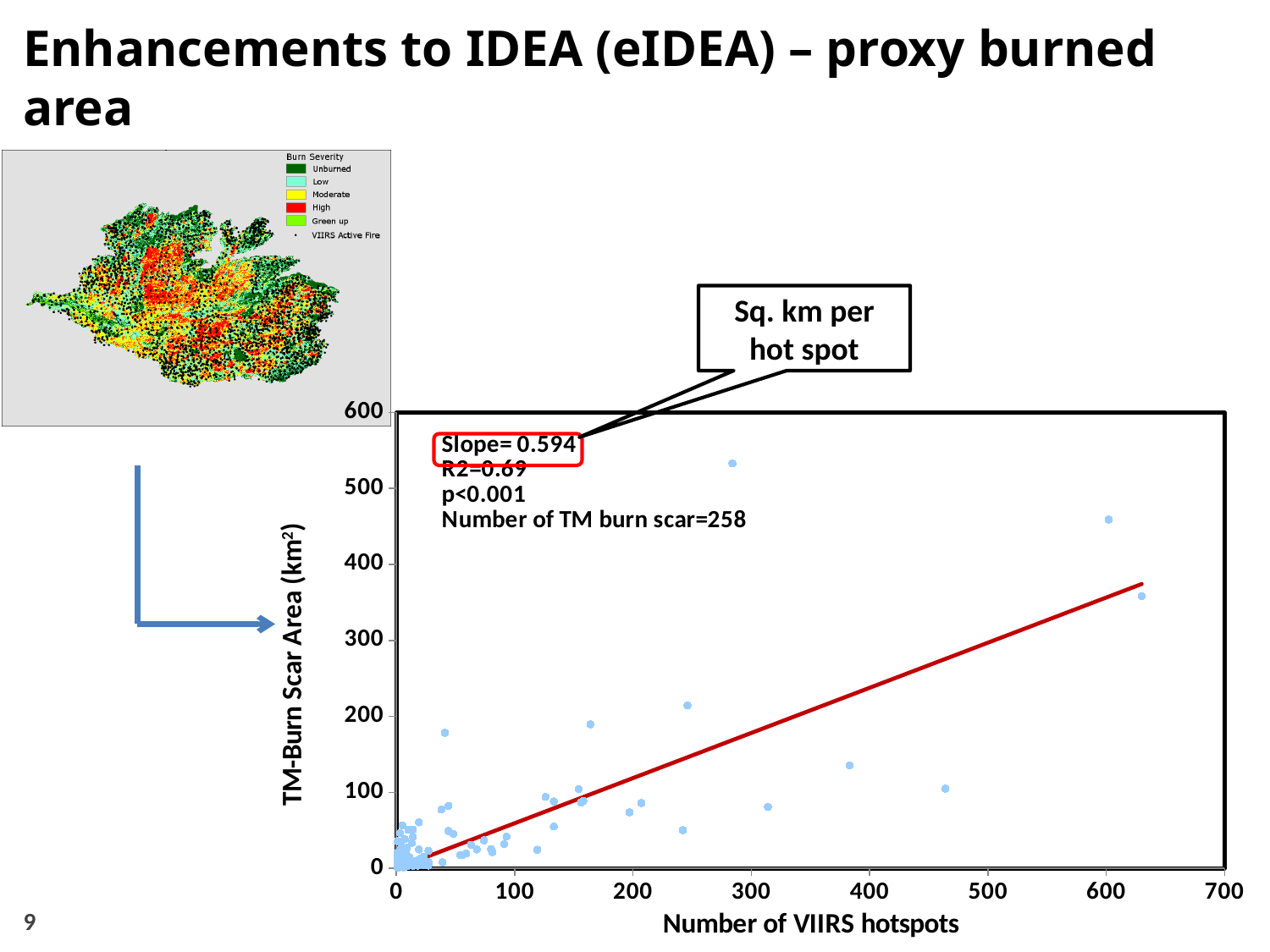
What p-value is printed on the chart? p<0.001 Is the TM-burn scar area of the point at roughly 600 VIIRS hotspots greater or less than 500? less What R2 value is printed on the chart? 0.69 What is the label of the x axis? Number of VIIRS hotspots Does the fitted line rise or fall as the number of VIIRS hotspots increases? rises What does the callout box say the slope represents? Sq. km per hot spot According to the annotation on the chart, how many TM burn scars are there? 258 Is the TM-burn scar area of the highest point on the chart greater or less than 500? greater What is the slope value printed on the chart? 0.594 What kind of chart is shown on the slide? scatter plot What is the highest tick value shown on the x axis? 700 What is the highest tick value shown on the y axis? 600